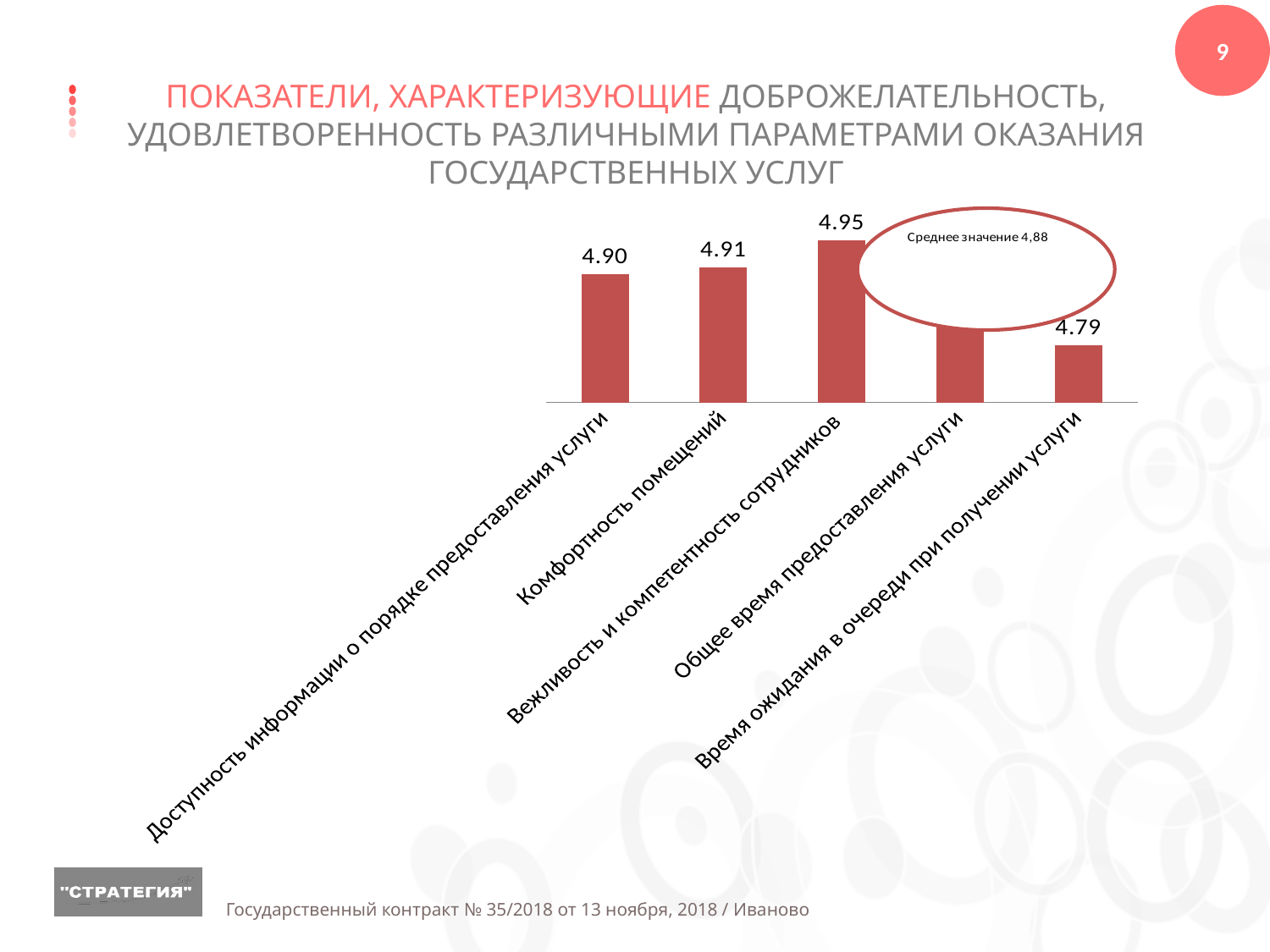
What is the difference between the values for «Вежливость и компетентность сотрудников» and «Время ожидания в очереди при получении услуги»? 0.16 What value is shown for «Комфортность помещений»? 4.91 What kind of chart is shown on the slide? Bar chart Which category has the lowest value? Время ожидания в очереди при получении услуги What value is shown for «Доступность информации о порядке предоставления услуги»? 4.90 Which is larger: the value for «Комфортность помещений» or for «Доступность информации о порядке предоставления услуги»? Комфортность помещений What value is shown for «Вежливость и компетентность сотрудников»? 4.95 How many categories are plotted in the chart? 5 What colour are the bars in the chart? Red Which category has the highest value? Вежливость и компетентность сотрудников What average value is stated in the oval callout on the chart? 4,88 What value is shown for «Время ожидания в очереди при получении услуги»? 4.79